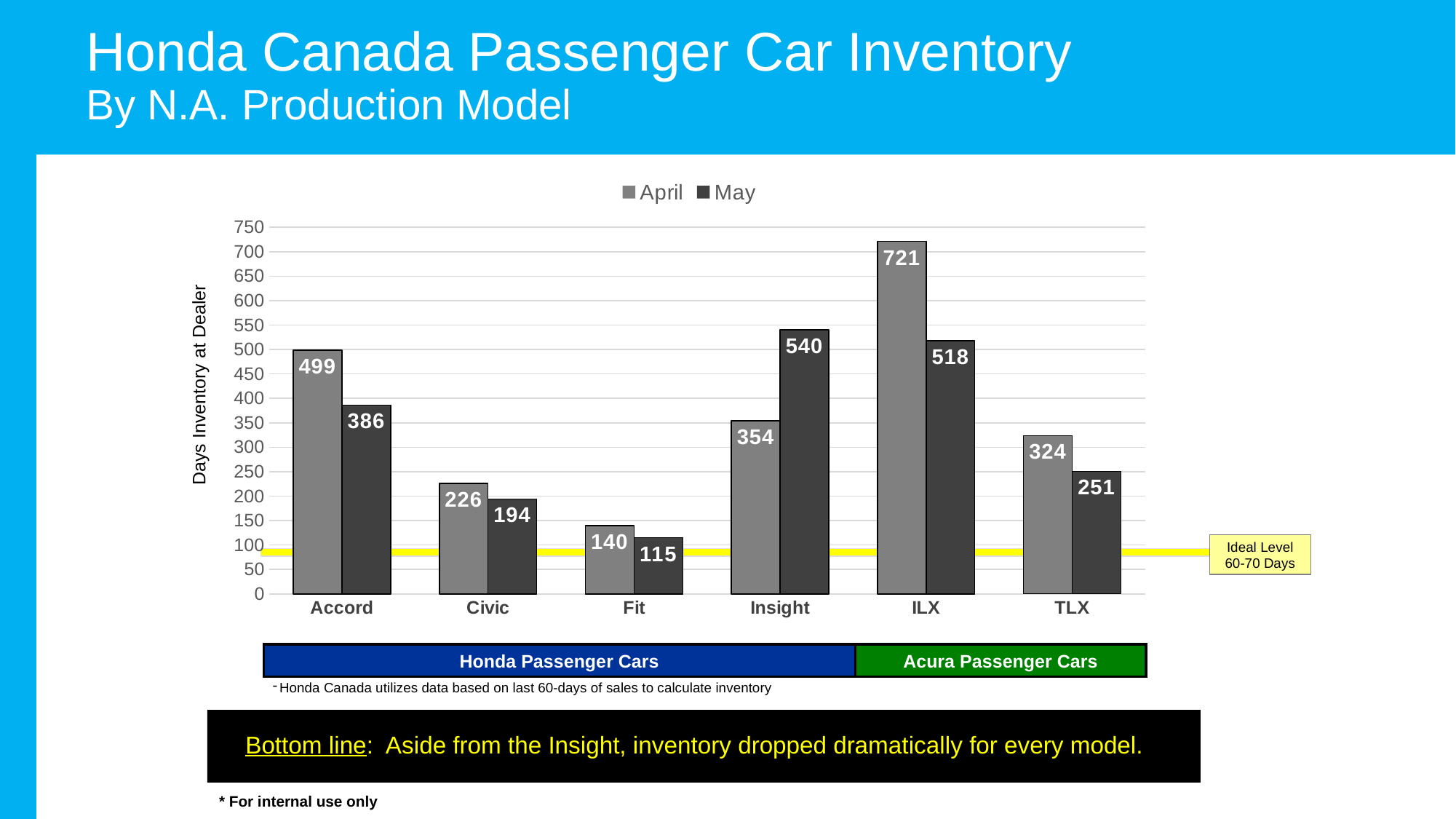
Which model has the lowest May days inventory? Fit Which model has the highest April days inventory? ILX What is the May days inventory value for the Insight? 540 What is the label on the vertical axis of the chart? Days Inventory at Dealer What is the April days inventory value for the Accord? 499 What kind of chart is shown on the slide? bar chart What is the difference between the April and May values for the ILX? 203 How many models are shown on the x axis of the chart? 6 Which is larger for the Insight, the April value or the May value? May Is the May value for the Accord greater or less than 400? less What is the May value for the TLX? 251 How many series does the chart legend list? 2